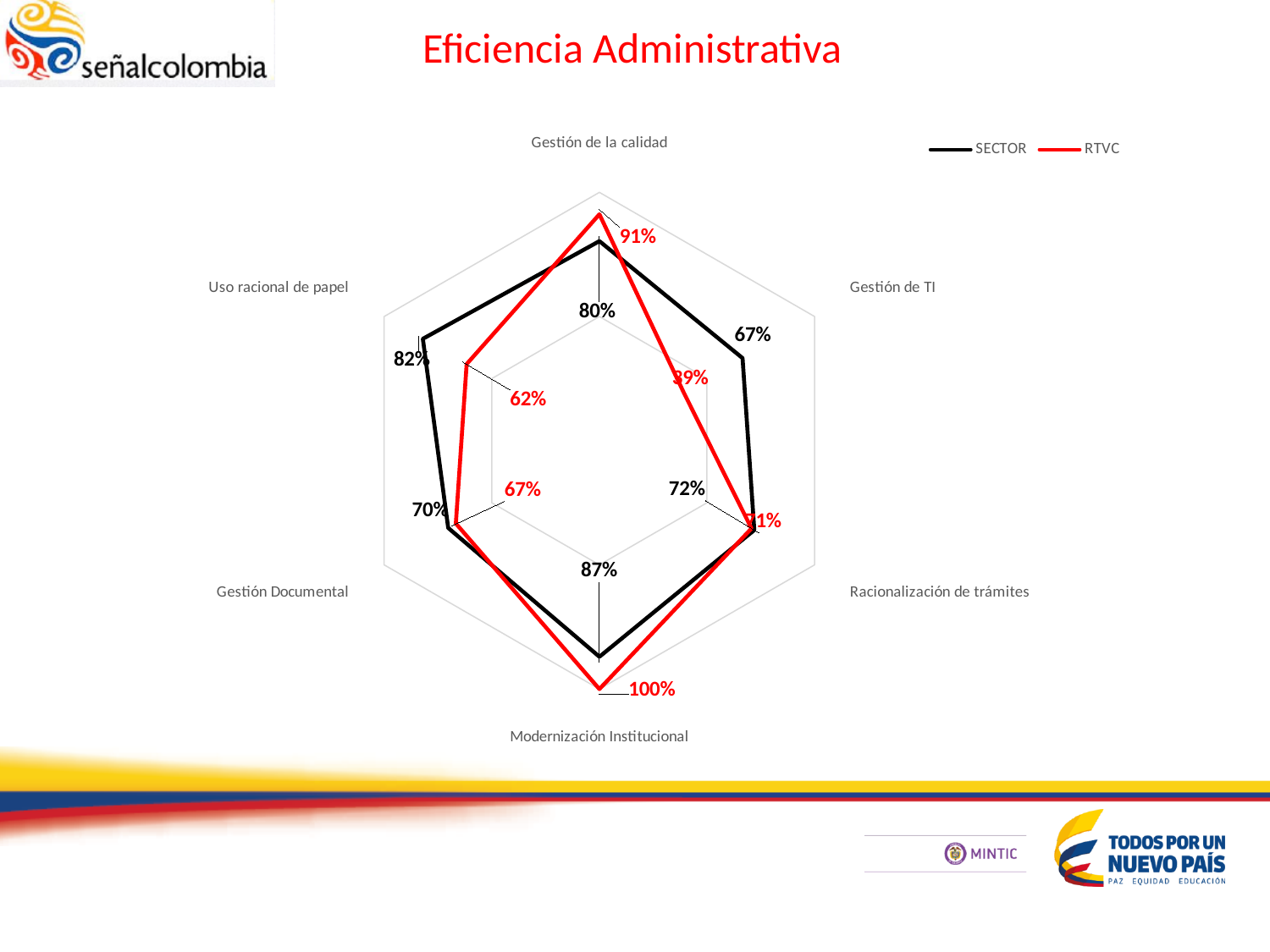
How many categories (axes) does the radar chart have? 6 What is the RTVC value for Modernización Institucional? 100% What kind of chart is shown on the slide? Radar chart In which category does the SECTOR series have its lowest value? Gestión de TI Which colour is used for the RTVC series? Red What is the SECTOR value for Uso racional de papel? 82% What is the RTVC value for Gestión Documental? 67% For Gestión de la calidad, which series has the higher value, SECTOR or RTVC? RTVC How many series does the legend list? 2 What is the difference between the SECTOR values for Modernización Institucional and Gestión de TI? 20 percentage points In which category does the SECTOR series have its highest value? Modernización Institucional What is the SECTOR value for Gestión de la calidad? 80%